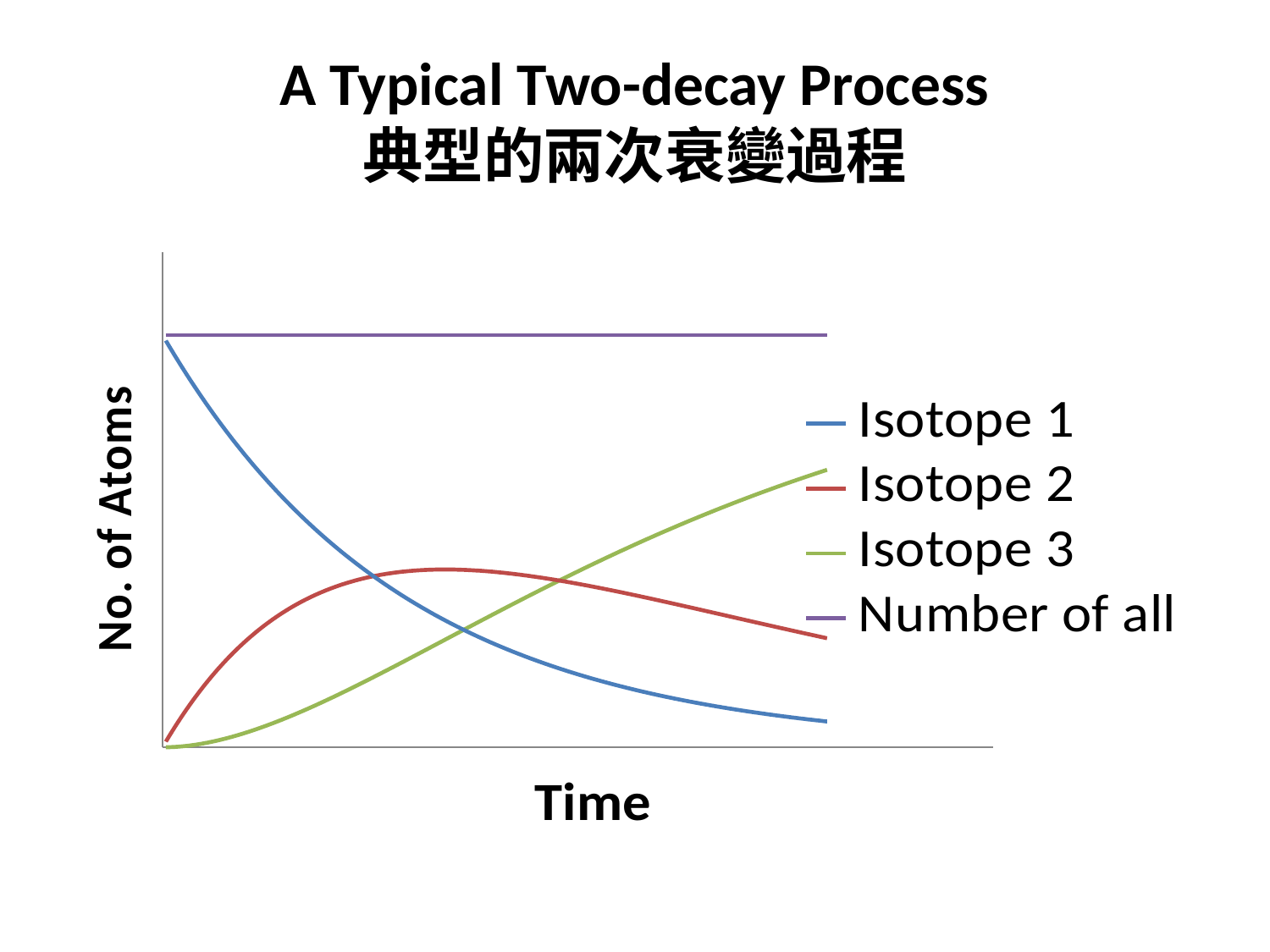
What is the label of the vertical axis? No. of Atoms Does the Isotope 1 line rise or fall as time increases? fall At the left end of the chart, which is larger: Isotope 1 or Isotope 3? Isotope 1 Does the Isotope 3 line rise or fall as time increases? rise Does the Isotope 2 line first rise and then fall, or first fall and then rise? first rise and then fall How many series does the legend list? 4 What is the label of the horizontal axis? Time What kind of chart is shown on the slide? line chart Among the three isotopes, which has the highest value at the right end of the chart? Isotope 3 Which series has the highest value at the right end of the chart? Number of all Which series has the lowest value at the right end of the chart? Isotope 1